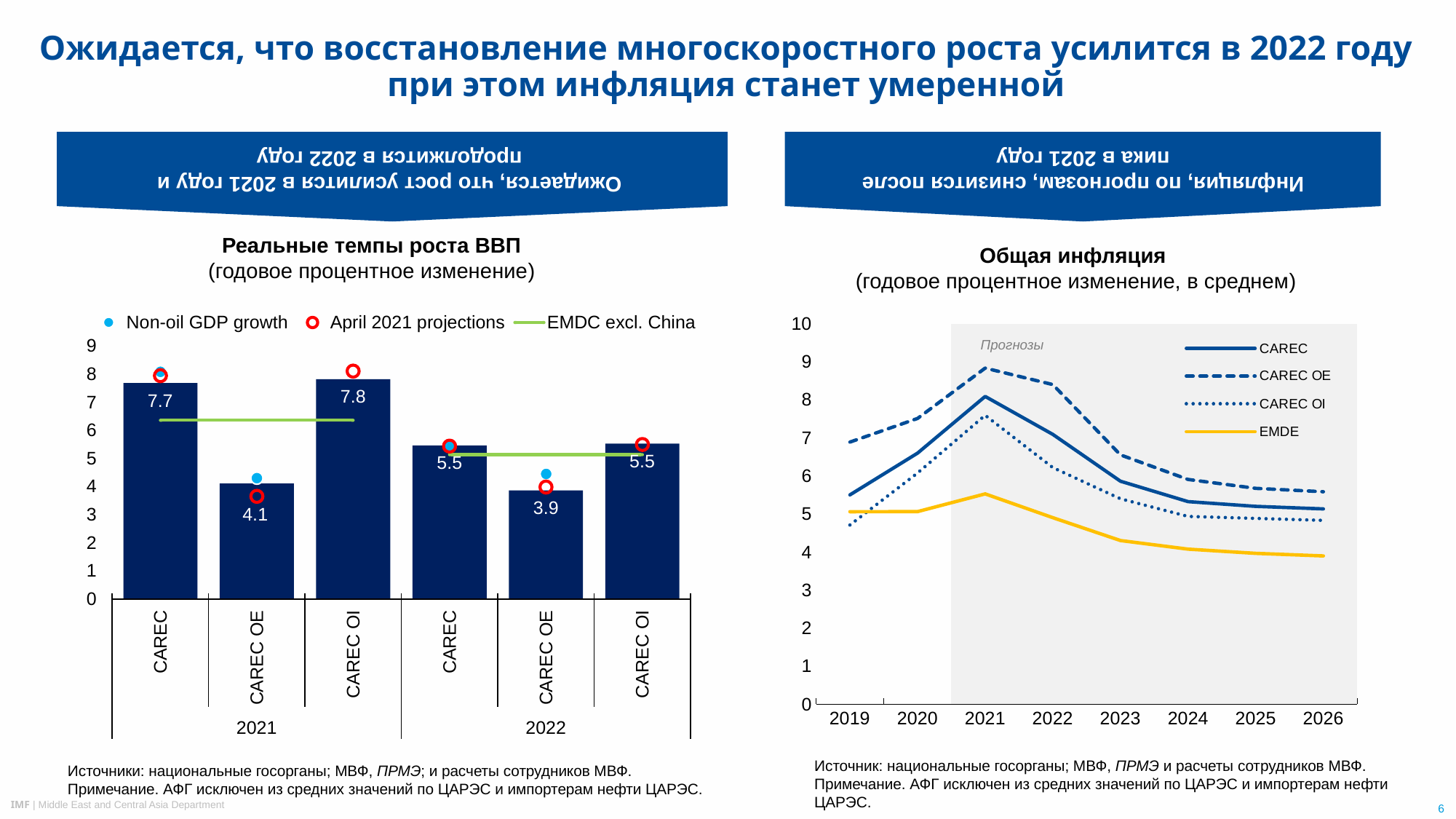
In the 'Реальные темпы роста ВВП' bar chart, is the CAREC OI value larger in 2021 or in 2022? 2021 How many series does the legend of the 'Общая инфляция' chart list? 4 In the 'Общая инфляция' chart, is the CAREC OE value for 2021 greater or less than 8? greater What kind of chart is the 'Общая инфляция' chart? Line chart How many series does the legend of the 'Реальные темпы роста ВВП' chart list? 3 In the 'Общая инфляция' chart, does the EMDE line rise or fall from 2021 to 2026? Fall In the 'Реальные темпы роста ВВП' bar chart, which bar has the highest value? CAREC OI in 2021 In the 'Реальные темпы роста ВВП' bar chart, what is the value for CAREC OE in 2022? 3.9 In the 'Реальные темпы роста ВВП' bar chart, what is the value for CAREC in 2021? 7.7 In the 'Реальные темпы роста ВВП' bar chart, which bar has the lowest value? CAREC OE in 2022 How many bars are plotted in the 'Реальные темпы роста ВВП' chart? 6 In the 'Реальные темпы роста ВВП' bar chart, what is the difference between the CAREC OE value in 2021 and in 2022? 0.2